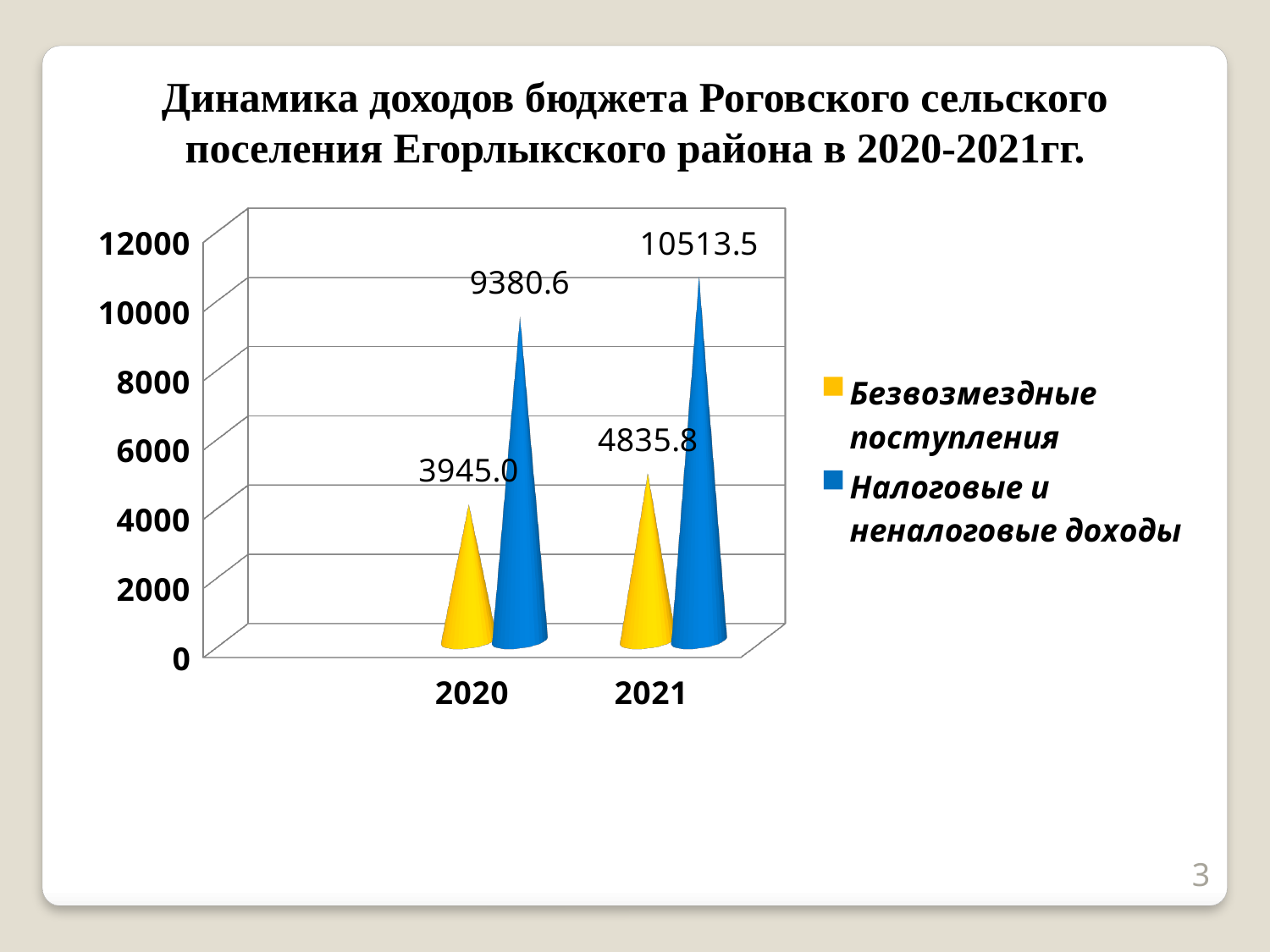
What is the value of Налоговые и неналоговые доходы for 2020? 9380.6 What is the value of Безвозмездные поступления for 2020? 3945.0 What is the value of Безвозмездные поступления for 2021? 4835.8 Is the value of Безвозмездные поступления for 2021 greater or less than 4000? greater How many years are shown on the x axis? 2 Does Безвозмездные поступления rise or fall from 2020 to 2021? rise In which year is Налоговые и неналоговые доходы highest? 2021 In which year is Безвозмездные поступления lowest? 2020 How many series does the legend list? 2 What is the value of Налоговые и неналоговые доходы for 2021? 10513.5 What is the difference between Налоговые и неналоговые доходы in 2021 and in 2020? 1132.9 Which is larger in 2021: Безвозмездные поступления or Налоговые и неналоговые доходы? Налоговые и неналоговые доходы